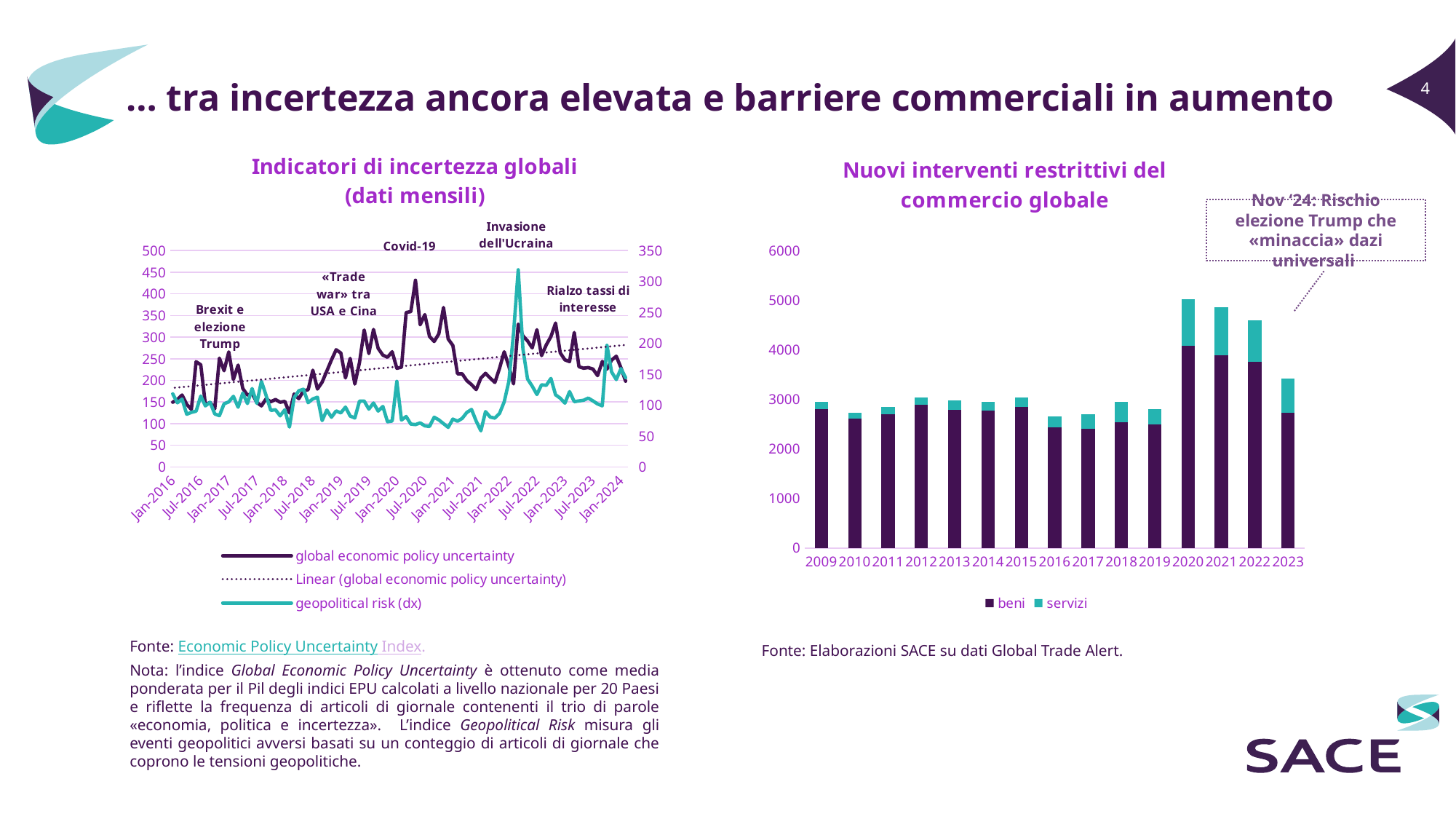
In the 'Nuovi interventi restrittivi del commercio globale' chart, is the total bar for 2016 greater or less than 3000? less In the 'Nuovi interventi restrittivi del commercio globale' chart, which year has the highest total bar? 2020 In the 'Nuovi interventi restrittivi del commercio globale' chart, how many years are shown on the x axis? 15 In the 'Nuovi interventi restrittivi del commercio globale' chart, which total bar is larger, 2021 or 2023? 2021 What kind of chart is the 'Nuovi interventi restrittivi del commercio globale' chart? stacked bar chart In the 'Nuovi interventi restrittivi del commercio globale' chart, how many series does the legend list? 2 In the 'Indicatori di incertezza globali (dati mensili)' chart, does the 'Linear (global economic policy uncertainty)' trend line rise or fall from Jan-2016 to Jan-2024? rise In the 'Indicatori di incertezza globali (dati mensili)' chart, how many entries does the legend list? 3 In the 'Nuovi interventi restrittivi del commercio globale' chart, is the total bar for 2023 greater or less than 4000? less What kind of chart is the 'Indicatori di incertezza globali (dati mensili)' chart? line chart In the 'Nuovi interventi restrittivi del commercio globale' chart, is the 'beni' value for 2020 greater or less than 4000? greater In the 'Indicatori di incertezza globali (dati mensili)' chart, which series is plotted on the right-hand (dx) axis? geopolitical risk (dx)